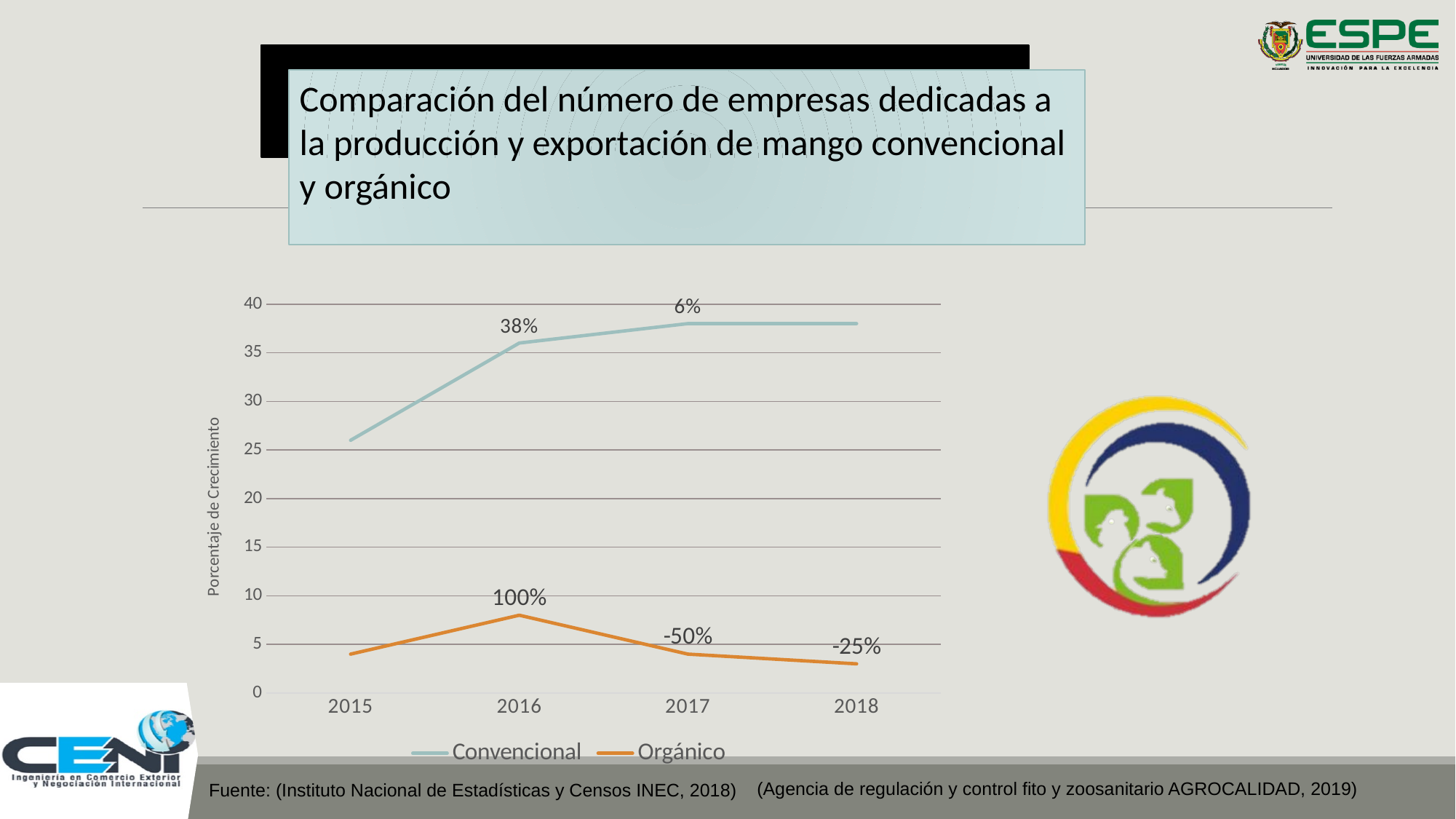
In which year does the Orgánico line reach its highest point? 2016 Is the value for Convencional in 2015 greater or less than 20? greater What data label is shown for the Convencional series in 2017? 6% What data label is shown for the Convencional series in 2016? 38% Does the Convencional line rise or fall from 2015 to 2017? rise What data label is shown for the Orgánico series in 2016? 100% Is the value for Orgánico in 2016 greater or less than 10? less What kind of chart is shown on the slide? line chart How many years are shown on the x axis? 4 What data label is shown for the Orgánico series in 2018? -25% How many series does the legend list? 2 In which year is the Convencional line at its lowest point? 2015